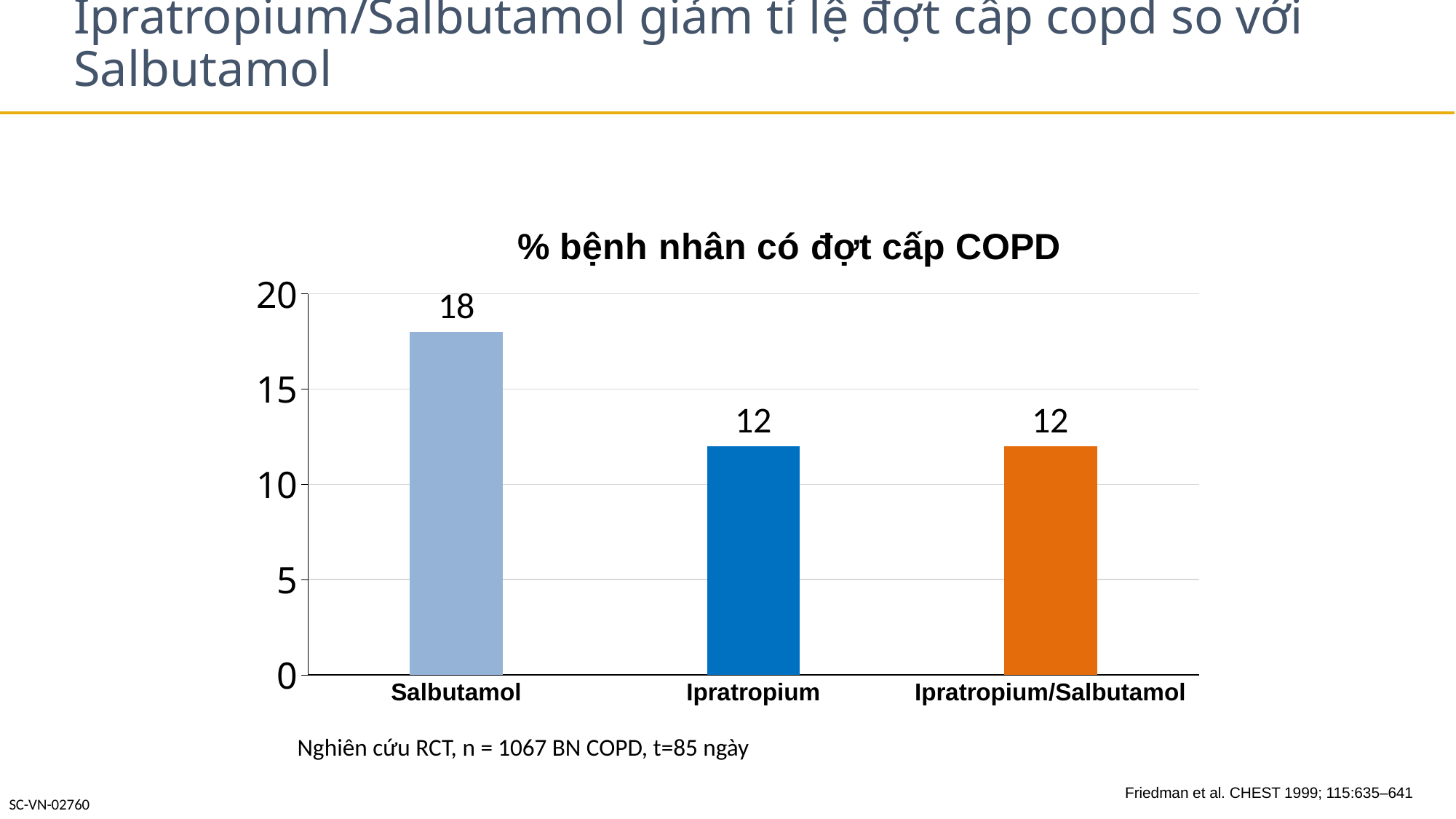
What is the value for Salbutamol? 18 What is the value for Ipratropium? 12 How many categories are shown on the x axis? 3 Is the value for Salbutamol greater or less than 15? greater What is the title of the chart? % bệnh nhân có đợt cấp COPD What colour is the bar for Ipratropium/Salbutamol? orange Which category has the highest value? Salbutamol What is the value for Ipratropium/Salbutamol? 12 Which is larger, the value for Salbutamol or the value for Ipratropium/Salbutamol? Salbutamol What is the difference between the values for Salbutamol and Ipratropium? 6 Is the value for Ipratropium greater or less than 15? less What kind of chart is shown on the slide? bar chart